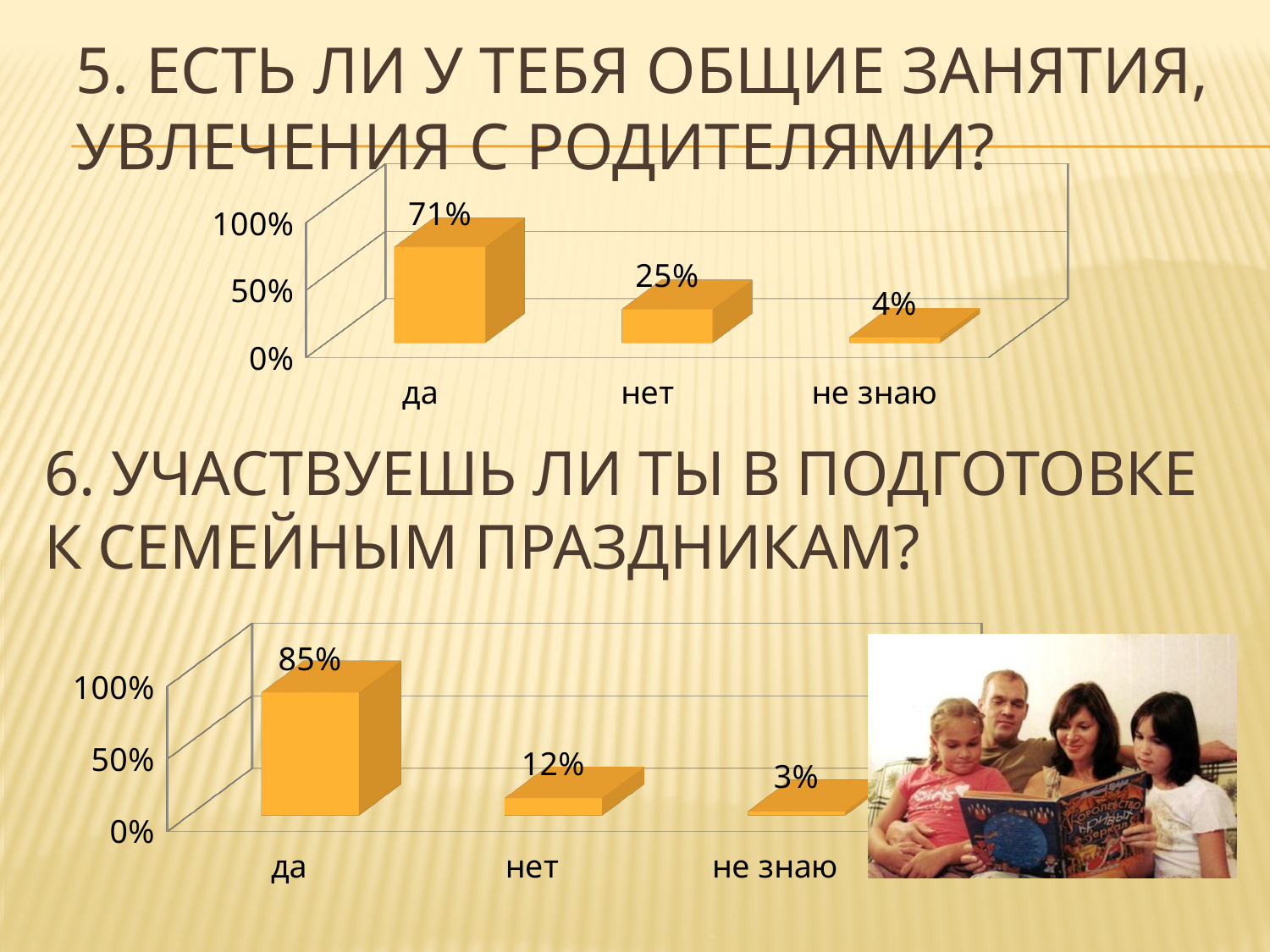
In the bottom chart (question 6), which is larger, "нет" or "не знаю"? нет In the top chart (question 5), what is the value for "нет"? 25% In the bottom chart (question 6), what is the value for "да"? 85% In the top chart (question 5), which category has the lowest value? не знаю In the top chart (question 5), what is the value for "да"? 71% In the bottom chart (question 6), what is the difference between "да" and "нет"? 73% In the top chart (question 5), what is the difference between "да" and "нет"? 46% In the top chart (question 5), how many categories are shown? 3 What kind of chart is the bottom chart (question 6)? bar chart In the bottom chart (question 6), which category has the highest value? да In the bottom chart (question 6), what is the value for "не знаю"? 3% In the top chart (question 5), do the values rise or fall from left to right? fall